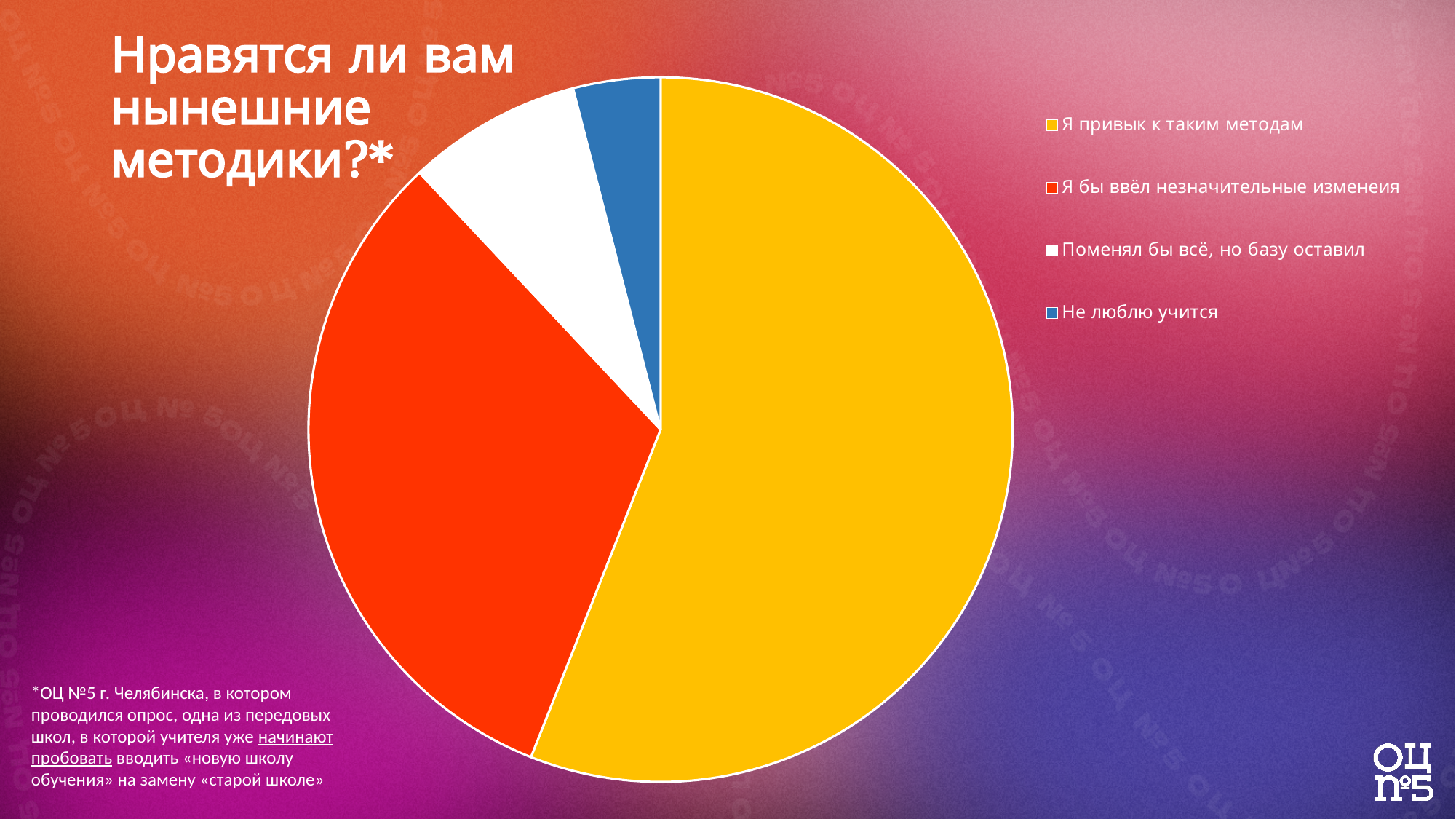
How many slices does the pie chart have? 4 Which slice is larger: "Поменял бы всё, но базу оставил" or "Не люблю учится"? Поменял бы всё, но базу оставил Which category has the smallest slice in the pie chart? Не люблю учится What colour is the slice for "Я привык к таким методам" in the pie chart? yellow What is the title of the slide with the pie chart? Нравятся ли вам нынешние методики?* Which slice is larger: "Я бы ввёл незначительные изменеия" or "Поменял бы всё, но базу оставил"? Я бы ввёл незначительные изменеия What kind of chart is shown on the slide? pie chart Which slice is larger: "Я привык к таким методам" or "Я бы ввёл незначительные изменеия"? Я привык к таким методам How many entries does the legend of the pie chart list? 4 Which category has the largest slice in the pie chart? Я привык к таким методам